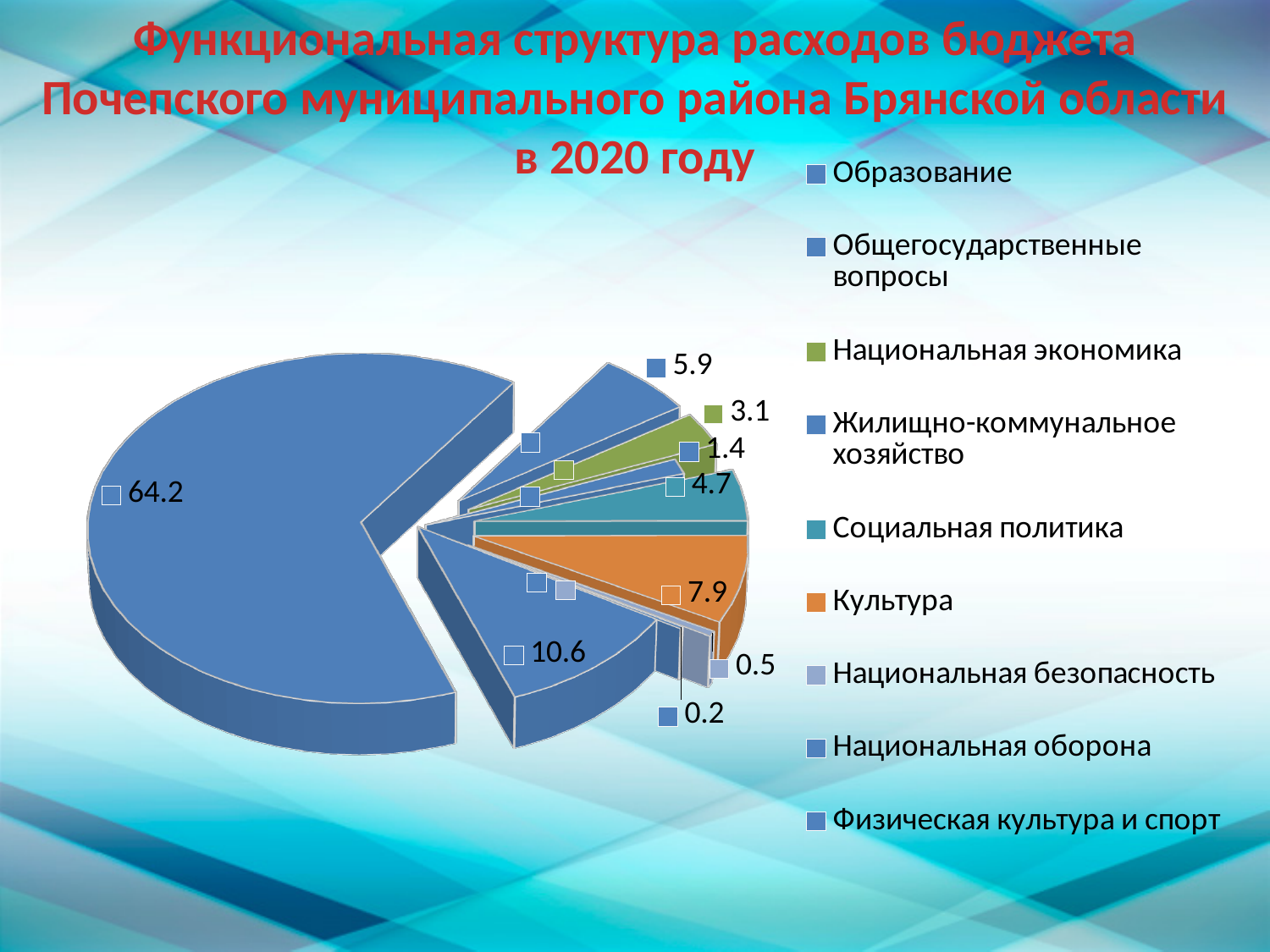
What value is shown for Социальная политика? 4.7 Which category has the largest slice in the pie chart? Образование What kind of chart is shown on the slide? Pie chart What is the difference between the values for Культура and Социальная политика? 3.2 What is the smallest value labelled on the pie chart? 0.2 What colour is the Культура slice in the pie chart? Orange What value is shown for Национальная безопасность? 0.5 What value is shown for the largest slice (Образование)? 64.2 What value is shown for Культура? 7.9 What value is shown for Национальная экономика? 3.1 How many slices does the pie chart have? 9 Which is larger, the value for Культура or the value for Национальная экономика? Культура